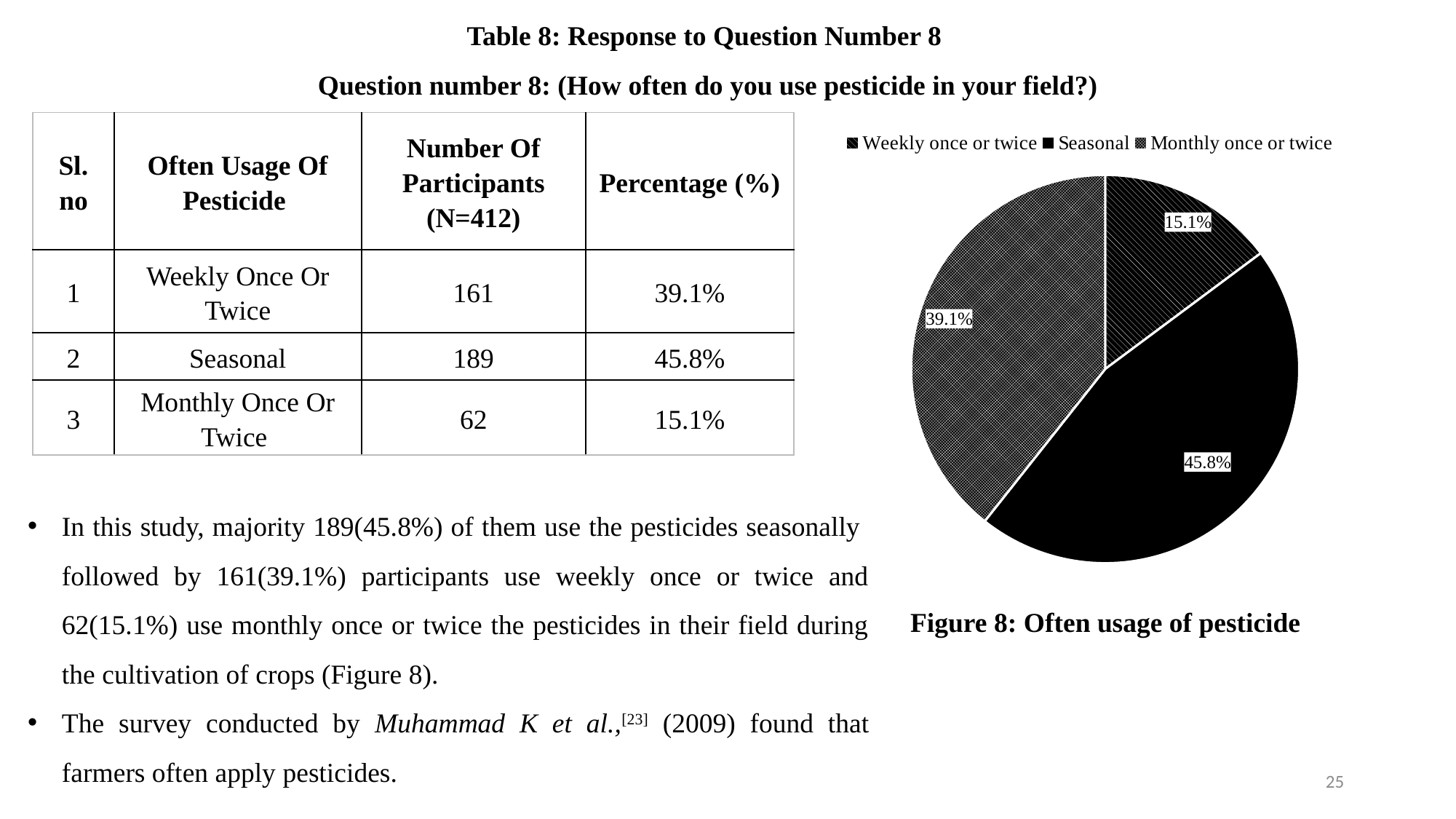
What kind of chart is shown in Figure 8? pie chart What is the difference between the 45.8% slice and the 39.1% slice in the pie chart? 6.7% Which legend entry is listed first in the pie chart's legend? Weekly once or twice In the pie chart, what share is labelled on the Seasonal slice? 45.8% How many entries does the legend of the pie chart list? 3 What is the percentage shown on the smallest slice of the pie chart? 15.1% Is the Seasonal slice of the pie chart larger or smaller than half of the pie? smaller Which category has the largest slice in the pie chart? Seasonal What is the caption of the pie chart? Figure 8: Often usage of pesticide What is the difference between the largest and smallest slice percentages in the pie chart? 30.7% What is the percentage shown on the largest slice of the pie chart? 45.8% How many slices does the pie chart in Figure 8 have? 3